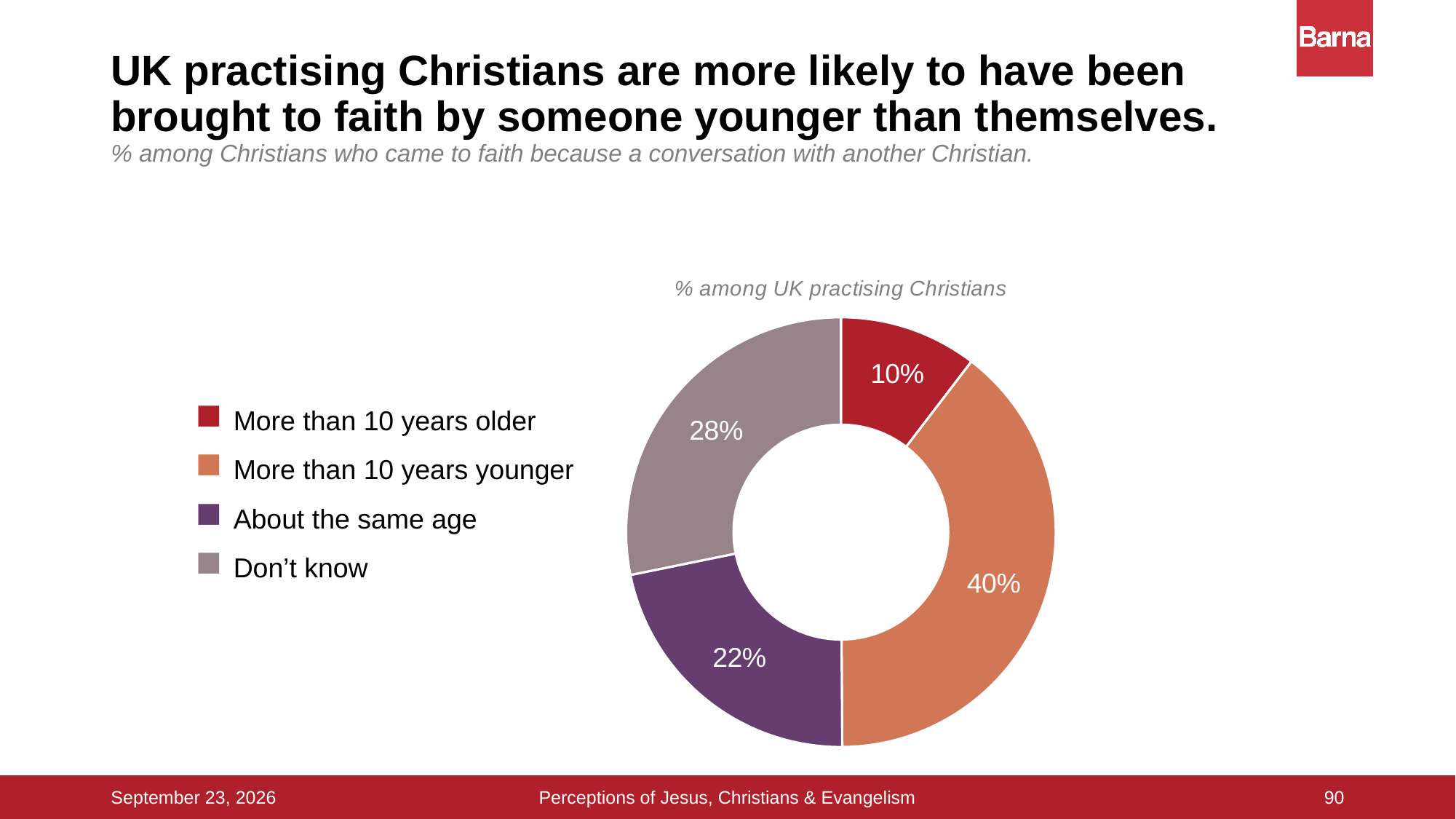
Which is larger: the share for 'Don't know' or the share for 'About the same age'? Don't know What kind of chart is shown on the slide? Pie chart (doughnut) What percentage of UK practising Christians were brought to faith by someone more than 10 years older? 10% What percentage of UK practising Christians were brought to faith by someone more than 10 years younger? 40% Which category has the largest share of the pie? More than 10 years younger What colour is the 'About the same age' slice? Purple What is the subtitle printed above the chart? % among UK practising Christians What percentage of UK practising Christians answered 'Don't know'? 28% How many categories does the chart show? 4 What percentage of UK practising Christians were brought to faith by someone about the same age? 22% Which category has the smallest share of the pie? More than 10 years older What is the difference in percentage points between 'More than 10 years younger' and 'More than 10 years older'? 30